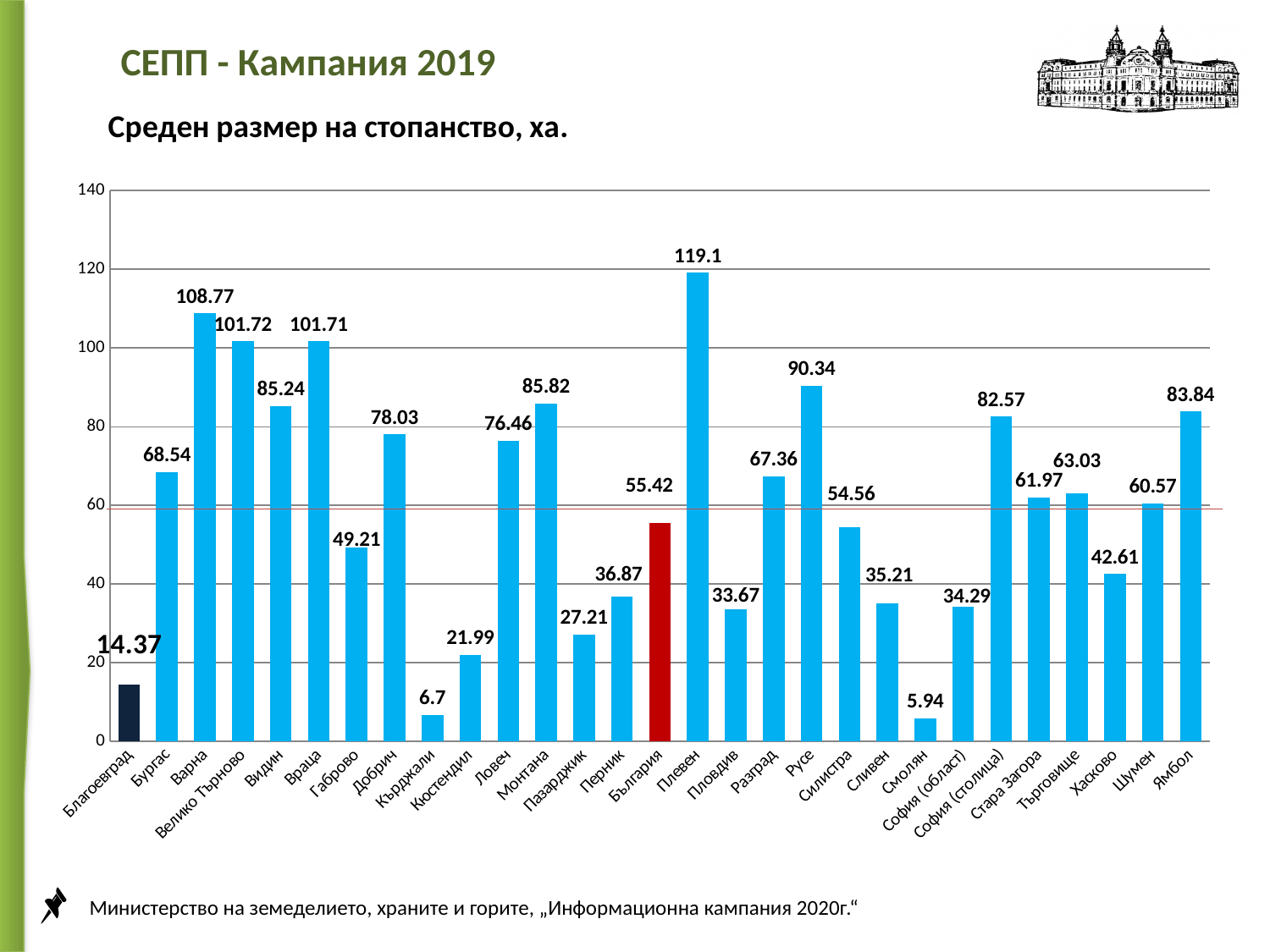
Which category's bar is coloured red? България What is the value for София (столица)? 82.57 What kind of chart is shown on the slide? bar chart Which category has the lowest value? Смолян What is the value for Кърджали? 6.7 How many categories are shown on the x axis? 29 What is the difference between the values for Плевен and България? 63.68 What is the value for България? 55.42 What is the value for Плевен? 119.1 Is the value for Добрич greater or less than 60? greater Which category has the highest value? Плевен Which is larger, the value for Русе or the value for Ямбол? Русе